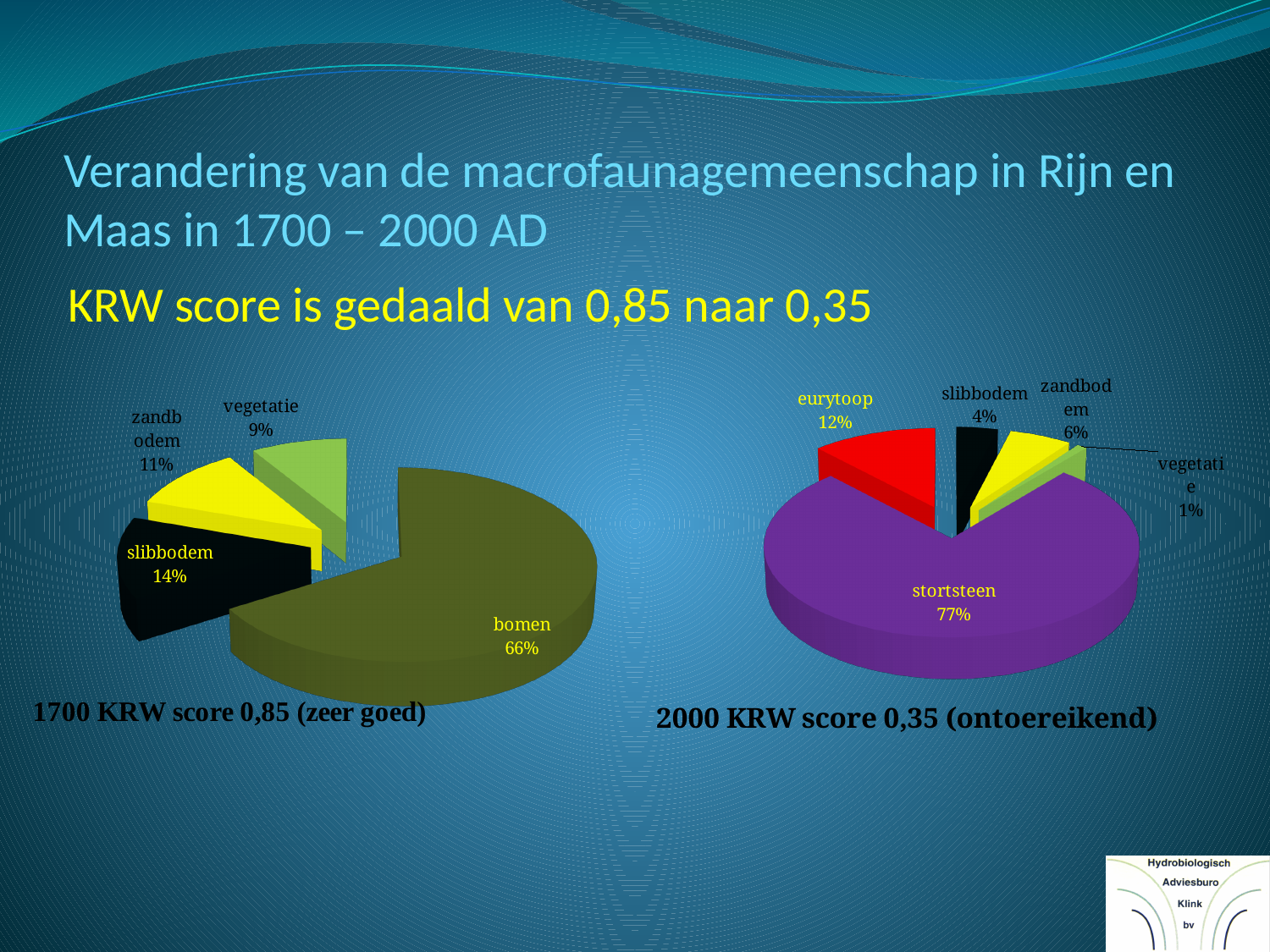
What type of chart is used on the left side of the slide (1700 KRW score 0,85)? Pie chart In the right pie chart (2000 KRW score 0,35), which is larger: the share of zandbodem or the share of slibbodem? zandbodem In the right pie chart (2000 KRW score 0,35), what share does eurytoop have? 12% In the left pie chart (1700 KRW score 0,85), which category has the largest share? bomen In the right pie chart (2000 KRW score 0,35), which category has the smallest share? vegetatie What is the caption below the right pie chart? 2000 KRW score 0,35 (ontoereikend) In the right pie chart (2000 KRW score 0,35), what share does stortsteen have? 77% In the left pie chart (1700 KRW score 0,85), what share does bomen have? 66% How many categories are shown in the left pie chart (1700 KRW score 0,85)? 4 In the left pie chart (1700 KRW score 0,85), what is the difference between the shares of slibbodem and vegetatie? 5% In the left pie chart (1700 KRW score 0,85), what share does slibbodem have? 14% How many categories are shown in the right pie chart (2000 KRW score 0,35)? 5